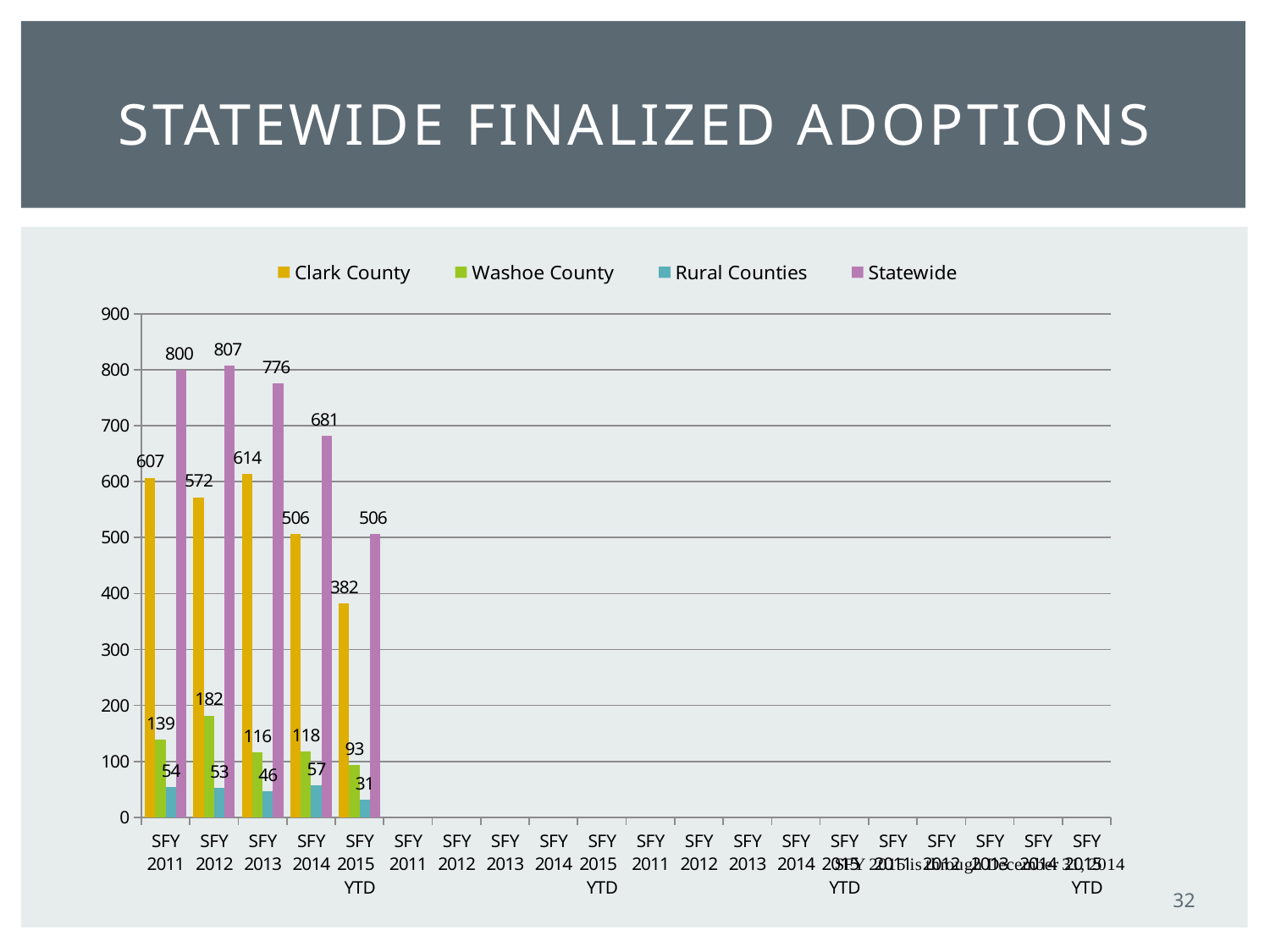
Which is larger, the Washoe County value for SFY 2013 or for SFY 2014? SFY 2014 Does the Statewide value rise or fall from SFY 2012 to SFY 2015 YTD? Fall In which year is the Statewide value highest? SFY 2012 What is the Rural Counties value for SFY 2013? 46 What is the difference between the Clark County values for SFY 2013 and SFY 2012? 42 How many series does the legend list? 4 What is the Statewide value for SFY 2012? 807 What is the Clark County value for SFY 2015 YTD? 382 What is the difference between the Statewide values for SFY 2011 and SFY 2014? 119 In which year is the Rural Counties value lowest? SFY 2015 YTD What is the Washoe County value for SFY 2012? 182 What kind of chart is shown on the slide? Bar chart